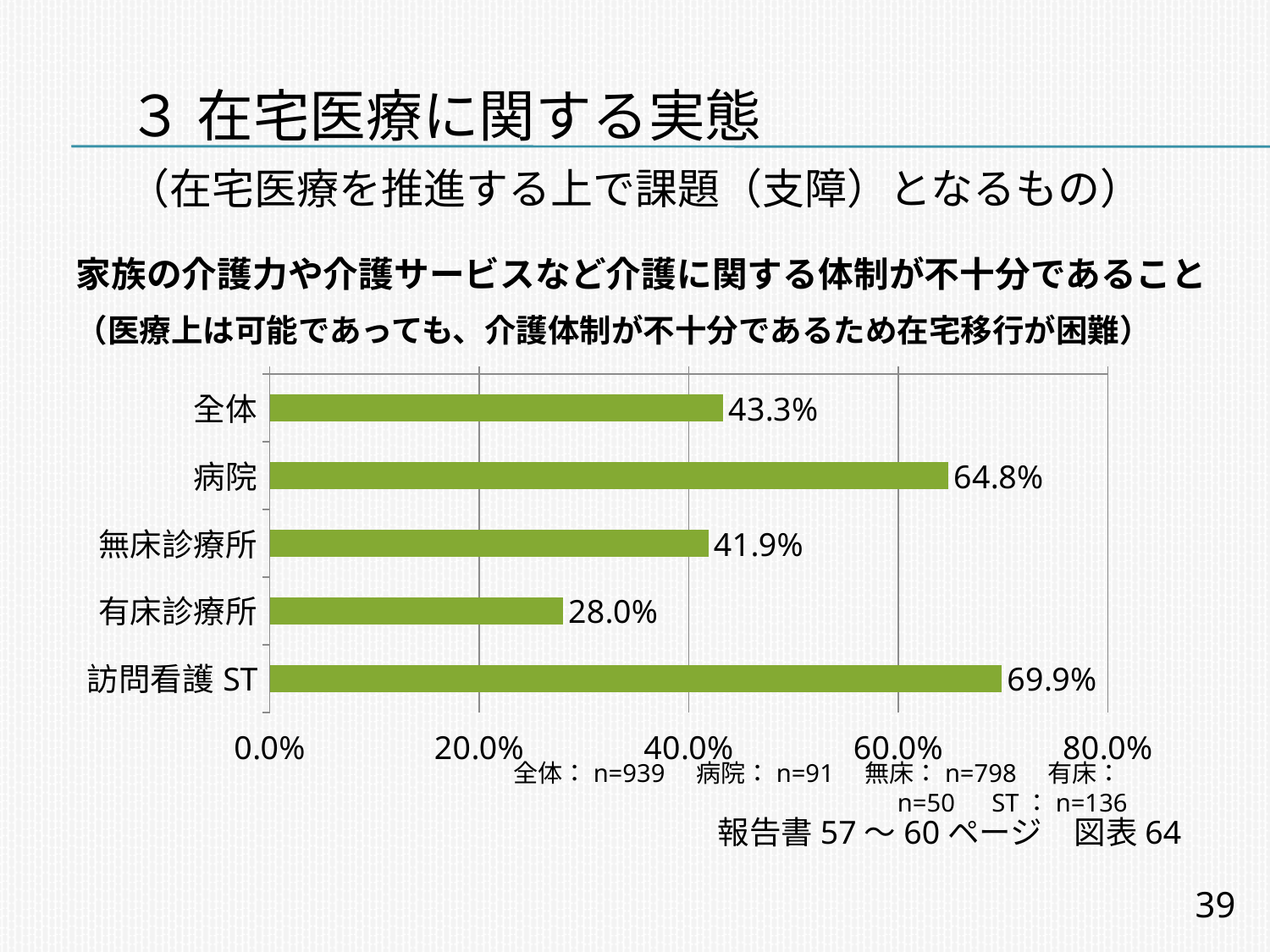
Which category has the highest value? 訪問看護ST How many categories are shown in the chart? 5 Which category has the lowest value? 有床診療所 What is the difference between the values for 訪問看護ST and 有床診療所? 41.9% What kind of chart is shown on the slide? bar chart What is the maximum value shown on the x axis? 80.0% What is the value for 全体? 43.3% What is the difference between the values for 病院 and 全体? 21.5% Which is larger, the value for 無床診療所 or the value for 病院? 病院 Is the value for 無床診療所 greater or less than 40.0%? greater What is the value for 有床診療所? 28.0% What is the value for 病院? 64.8%